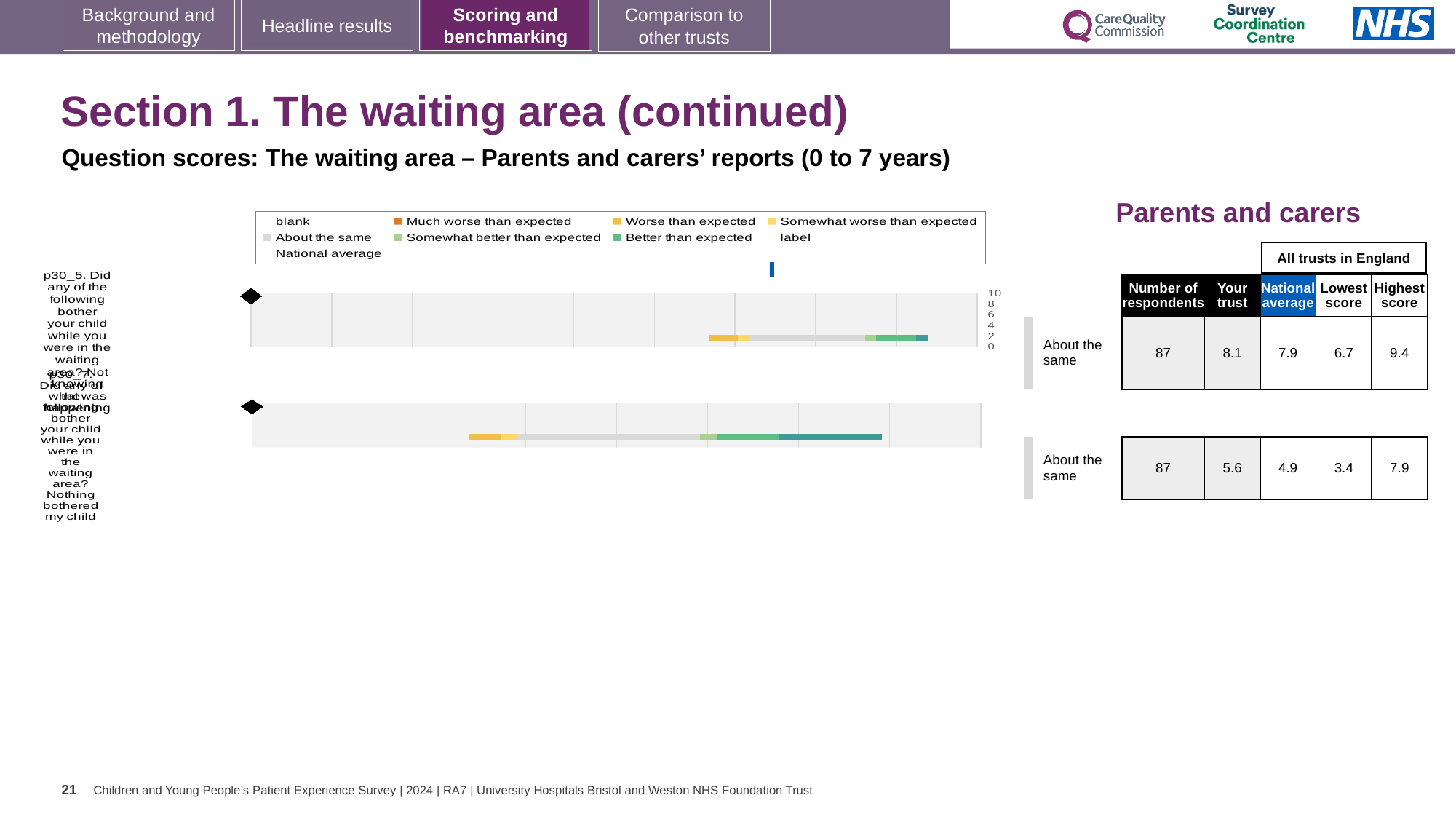
In the table beside the chart, what is the difference between the highest score and the lowest score for the second question (p30_7)? 4.5 In the table beside the chart, which question has the higher 'Your trust' score, p30_5 or p30_7? p30_5 How many entries does the chart legend list? 9 In the table beside the chart, what is the national average for the first question (p30_5)? 7.9 Which legend entry is shown in orange? Much worse than expected How many question bars are plotted in the chart? 2 In the table beside the chart, what is the 'Your trust' score for the second question (p30_7)? 5.6 In the table beside the chart, what is the difference between the 'Your trust' score and the national average for the first question (p30_5)? 0.2 In the table beside the chart, what is the number of respondents for each question? 87 What is the highest value shown on the chart's axis? 10 In the table beside the chart, what is the 'Your trust' score for the first question (p30_5)? 8.1 What kind of chart is shown on the slide? bar chart